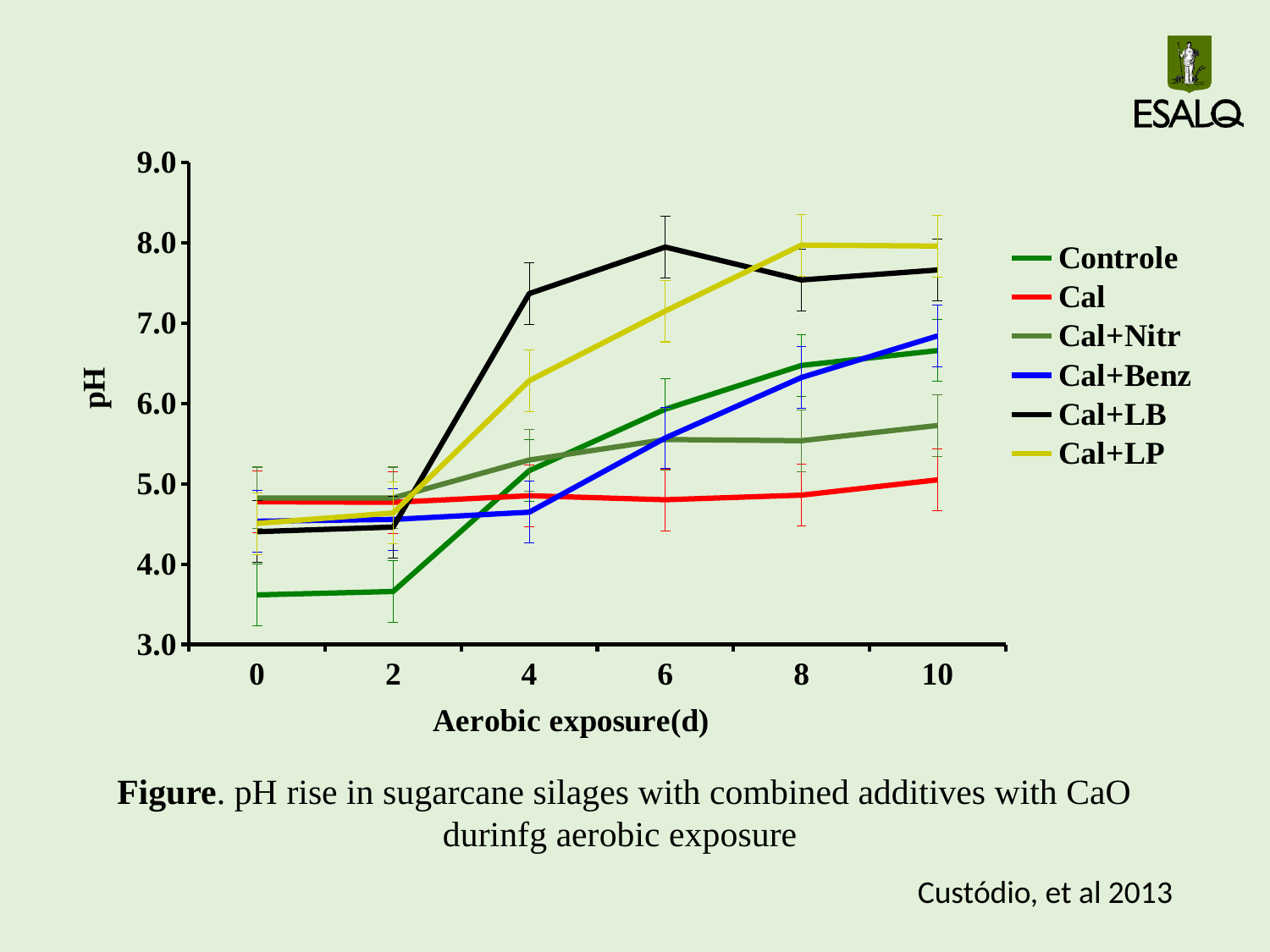
Is the pH value for Cal at day 10 greater or less than 6.0? less Which series has the lowest pH at day 0? Controle Is the pH value for Controle at day 0 greater or less than 4.0? less At day 4, which has the higher pH, Cal+LB or Cal+LP? Cal+LB Which series has the highest pH at day 8? Cal+LP Is the pH value for Cal+LB at day 6 greater or less than 7.0? greater How many series does the legend list? 6 Does the pH of Controle rise or fall from day 0 to day 10? rise What is the label of the x axis? Aerobic exposure(d) Which series has the lowest pH at day 10? Cal What kind of chart is shown on the slide? line chart How many aerobic exposure time points are marked on the x axis? 6